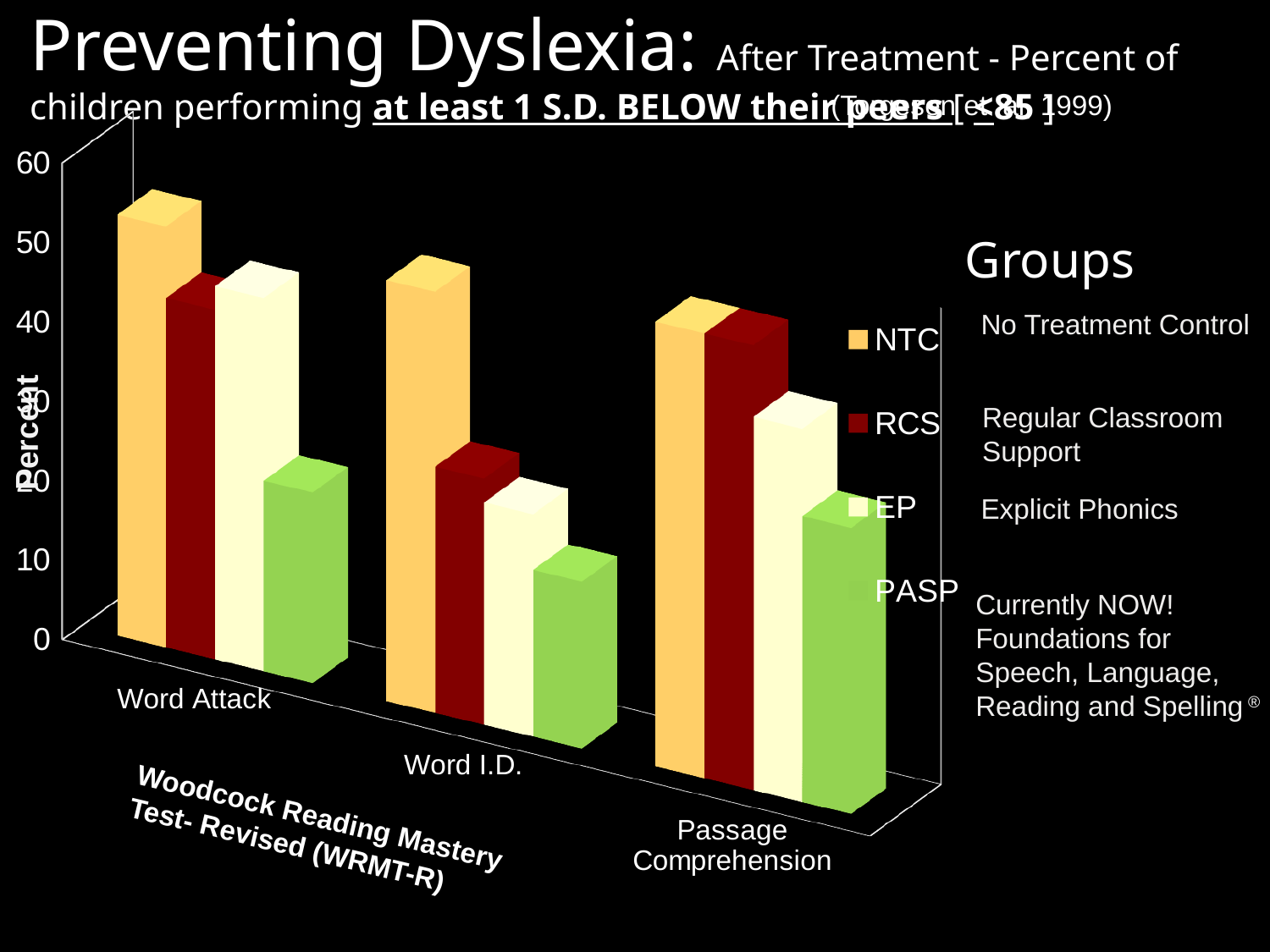
Is the value for PASP on Word Attack greater or less than 30? less What kind of chart is shown on the slide? bar chart How many test categories are shown along the x axis of the chart? 3 Which group has the lowest bar for Word Attack? PASP How many groups (series) does the chart's legend list? 4 For Passage Comprehension, which is larger, the NTC bar or the PASP bar? NTC Which group has the highest bar for Word I.D.? NTC Which group has the lowest bar for Word I.D.? PASP What is the label on the vertical axis of the chart? Percent Which group has the highest bar for Word Attack? NTC Is the value for NTC on Word Attack greater or less than 40? greater